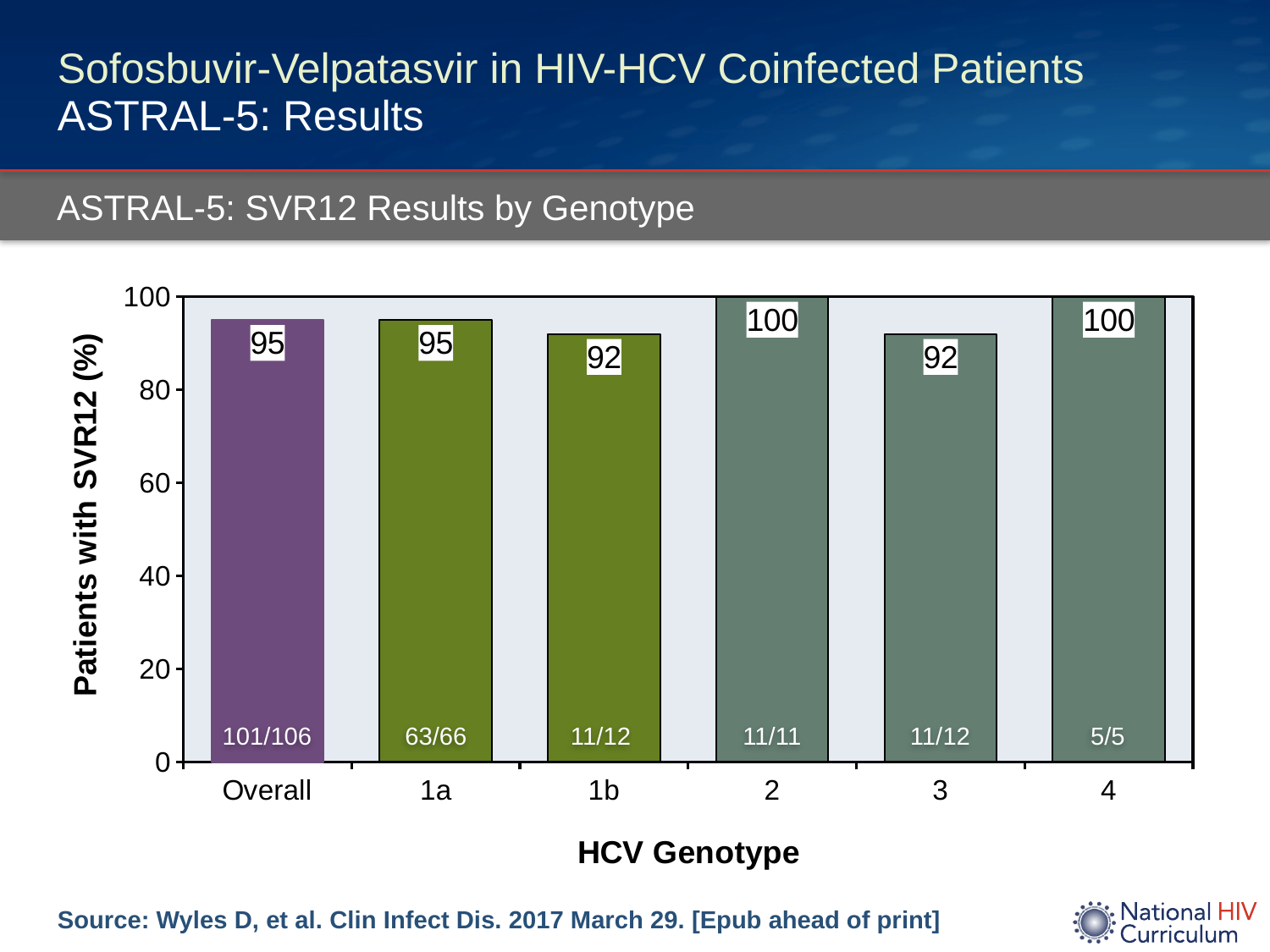
How many categories are shown on the x axis? 6 What kind of chart is shown on the slide? Bar chart Which has a higher SVR12 rate, genotype 1a or genotype 1b? 1a What is the SVR12 rate (%) for the Overall group? 95 What is the label of the y axis? Patients with SVR12 (%) What is the difference in SVR12 rate between genotype 2 and genotype 3? 8 Which HCV genotypes have the highest SVR12 rate? 2 and 4 What is the SVR12 rate (%) for HCV genotype 1b? 92 What is the title of the chart? ASTRAL-5: SVR12 Results by Genotype What fraction of patients achieved SVR12 in genotype 1a? 63/66 What is the SVR12 rate (%) for HCV genotype 3? 92 What fraction of patients achieved SVR12 in genotype 4? 5/5